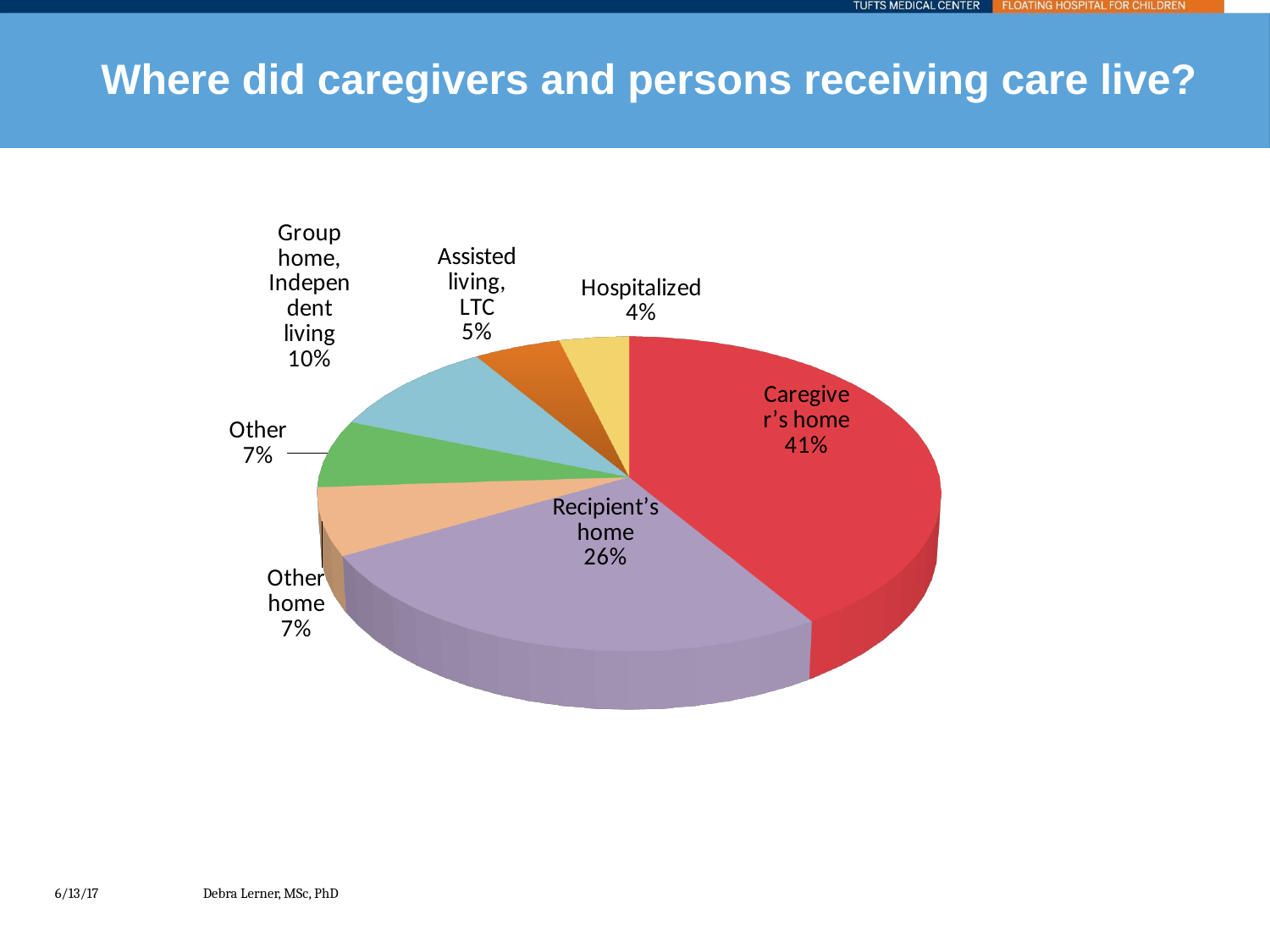
What is the difference in percentage points between Caregiver's home and Recipient's home? 15 What percentage is shown for Group home, Independent living? 10% What percentage is shown for Hospitalized? 4% What share of the pie is labelled Caregiver's home? 41% Which category has the largest slice of the pie? Caregiver's home What percentage is shown for Assisted living, LTC? 5% What kind of chart is shown on the slide? Pie chart What share of the pie is labelled Recipient's home? 26% Which is larger, the share for Group home, Independent living or the share for Assisted living, LTC? Group home, Independent living Which category has the smallest slice of the pie? Hospitalized What is the title of the slide containing the pie chart? Where did caregivers and persons receiving care live? How many slices does the pie chart have? 7